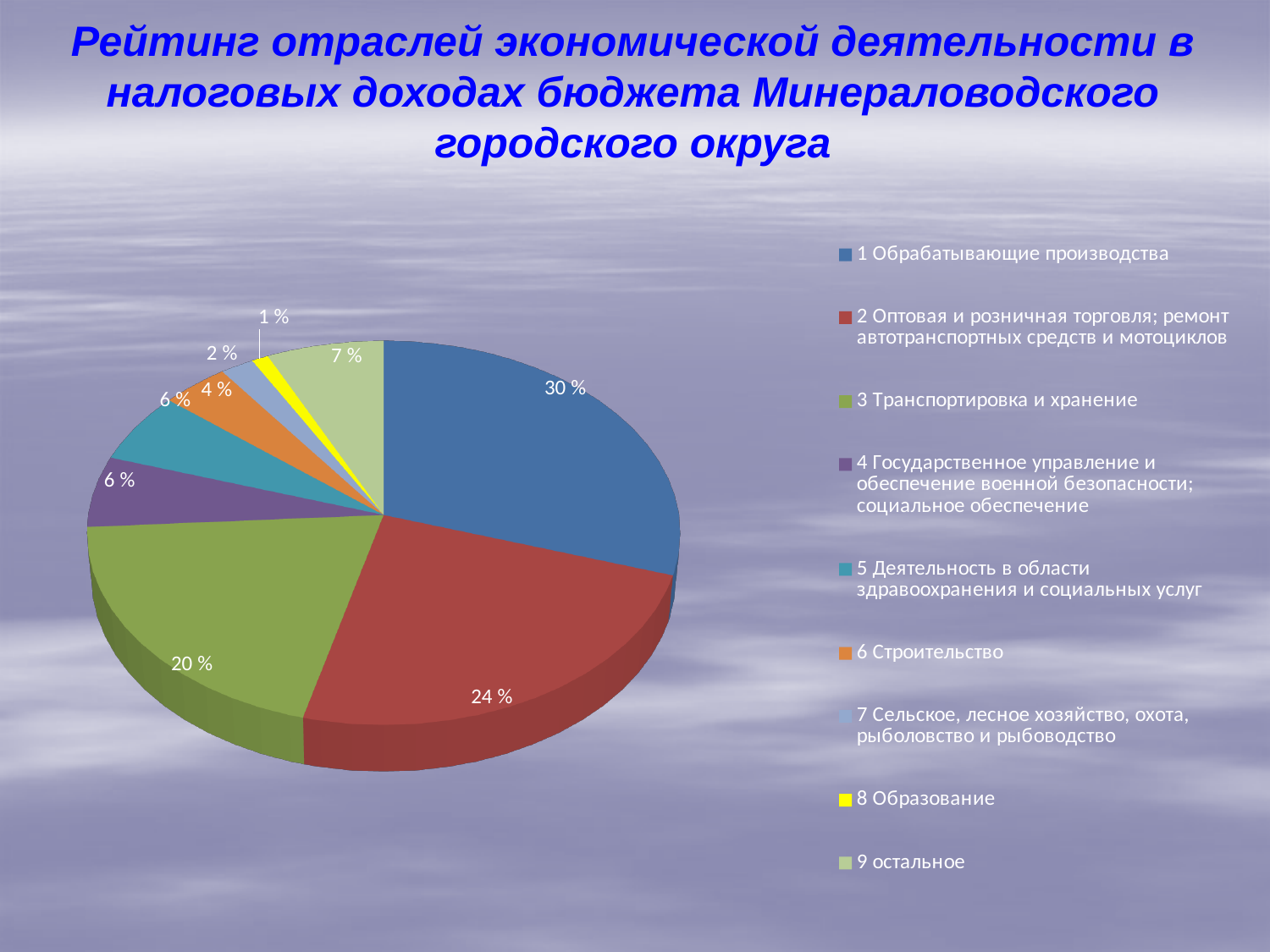
What share of tax revenues does "Обрабатывающие производства" account for? 30 % What share is shown for "Транспортировка и хранение"? 20 % What share is shown for "Строительство"? 4 % What share is shown for "остальное"? 7 % What share is shown for "Образование"? 1 % Which sector has the largest share of the pie? Обрабатывающие производства What is the difference in percentage points between "Обрабатывающие производства" and "Транспортировка и хранение"? 10 What kind of chart is shown on the slide? pie chart What share is shown for "Оптовая и розничная торговля; ремонт автотранспортных средств и мотоциклов"? 24 % Which sector has the smallest share of the pie? Образование Which is larger: the share for "Строительство" or the share for "остальное"? остальное How many slices does the pie chart have? 9